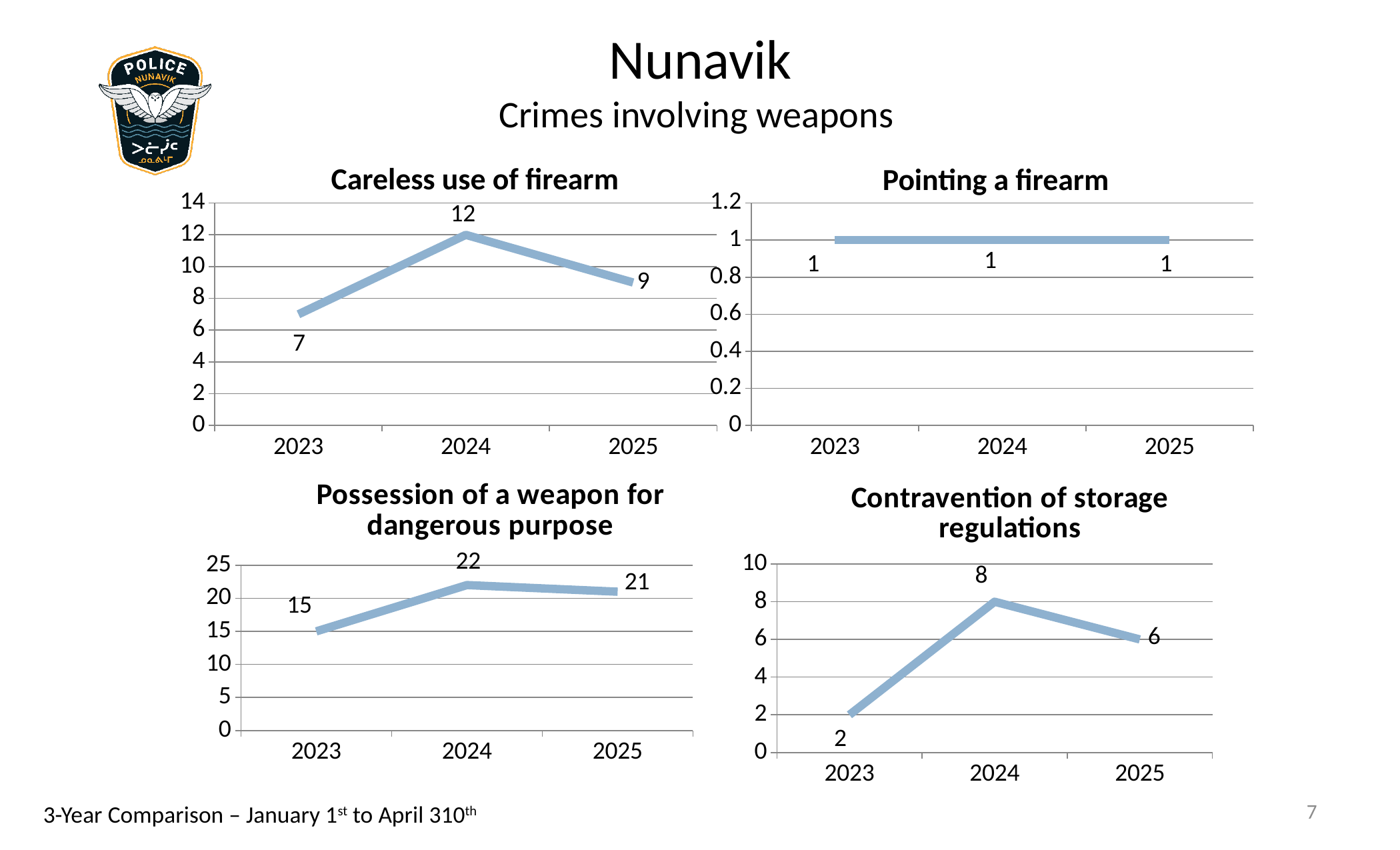
In the 'Contravention of storage regulations' chart, what is the difference between the 2024 and 2023 values? 6 In the 'Contravention of storage regulations' chart, which is larger, the value for 2023 or the value for 2025? 2025 In the 'Contravention of storage regulations' chart, what is the value for 2024? 8 In the 'Pointing a firearm' chart, do the values rise, fall or stay flat from 2023 to 2025? stay flat In the 'Careless use of firearm' chart, which year has the lowest value? 2023 In the 'Careless use of firearm' chart, what is the value for 2024? 12 In the 'Careless use of firearm' chart, what is the difference between the 2024 and 2025 values? 3 In the 'Pointing a firearm' chart, what is the value for 2025? 1 In the 'Possession of a weapon for dangerous purpose' chart, is the value for 2025 greater or less than 20? greater In the 'Possession of a weapon for dangerous purpose' chart, which year has the highest value? 2024 What kind of chart is the 'Careless use of firearm' chart? line chart In the 'Possession of a weapon for dangerous purpose' chart, what is the value for 2023? 15